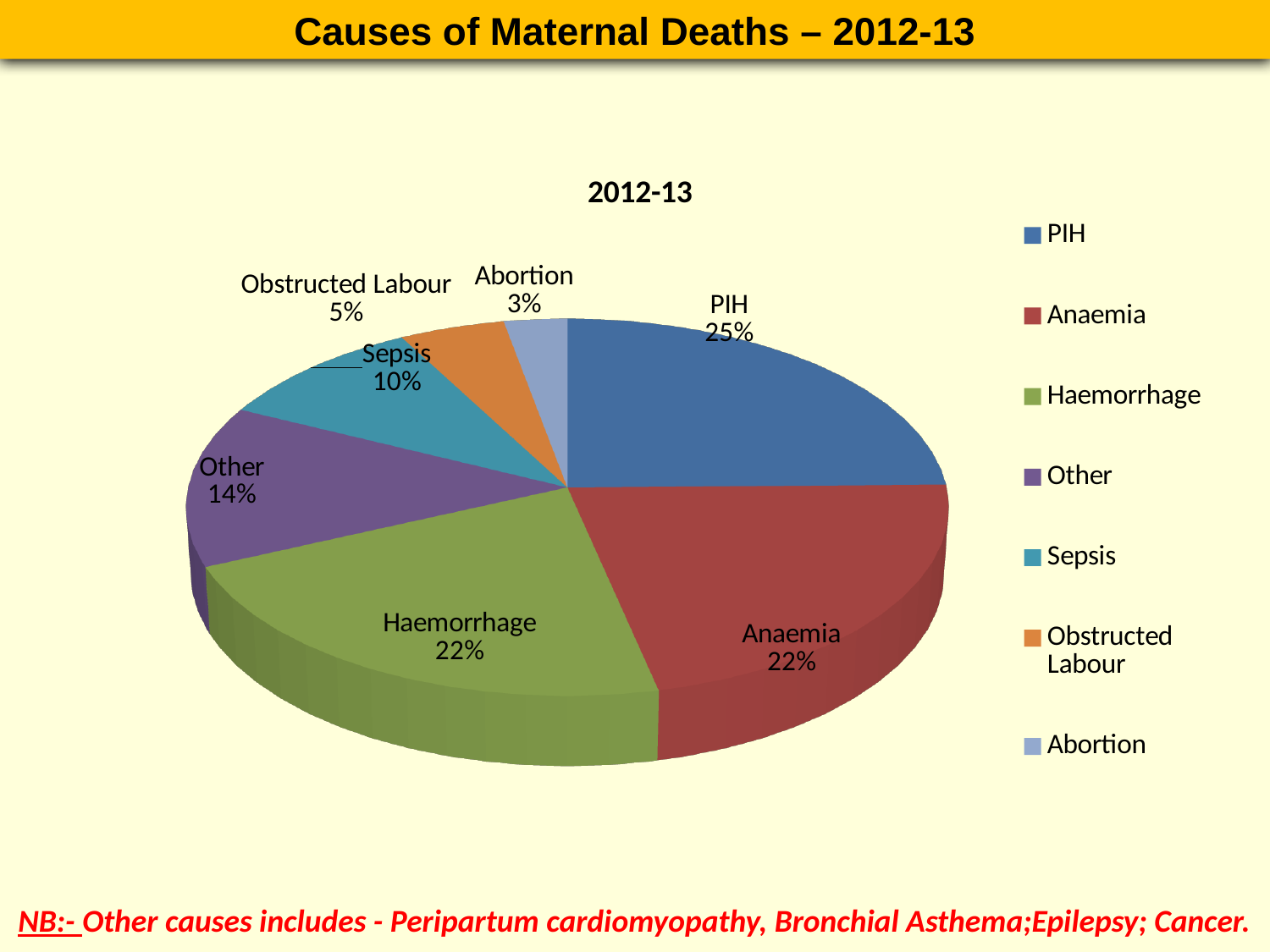
What colour is the Haemorrhage slice in the pie chart? Green What percentage is shown for Obstructed Labour? 5% What share of maternal deaths is attributed to PIH? 25% Which cause has the smallest share of maternal deaths? Abortion Which is larger, the share for PIH or the share for Haemorrhage? PIH What share does Abortion account for in the pie chart? 3% What percentage of maternal deaths is due to Sepsis? 10% What type of chart is shown on the slide? Pie chart What is the title shown above the pie chart? 2012-13 How many causes (slices) are shown in the pie chart? 7 Which cause has the largest share of maternal deaths? PIH What is the difference in percentage points between the Other slice and the Sepsis slice? 4